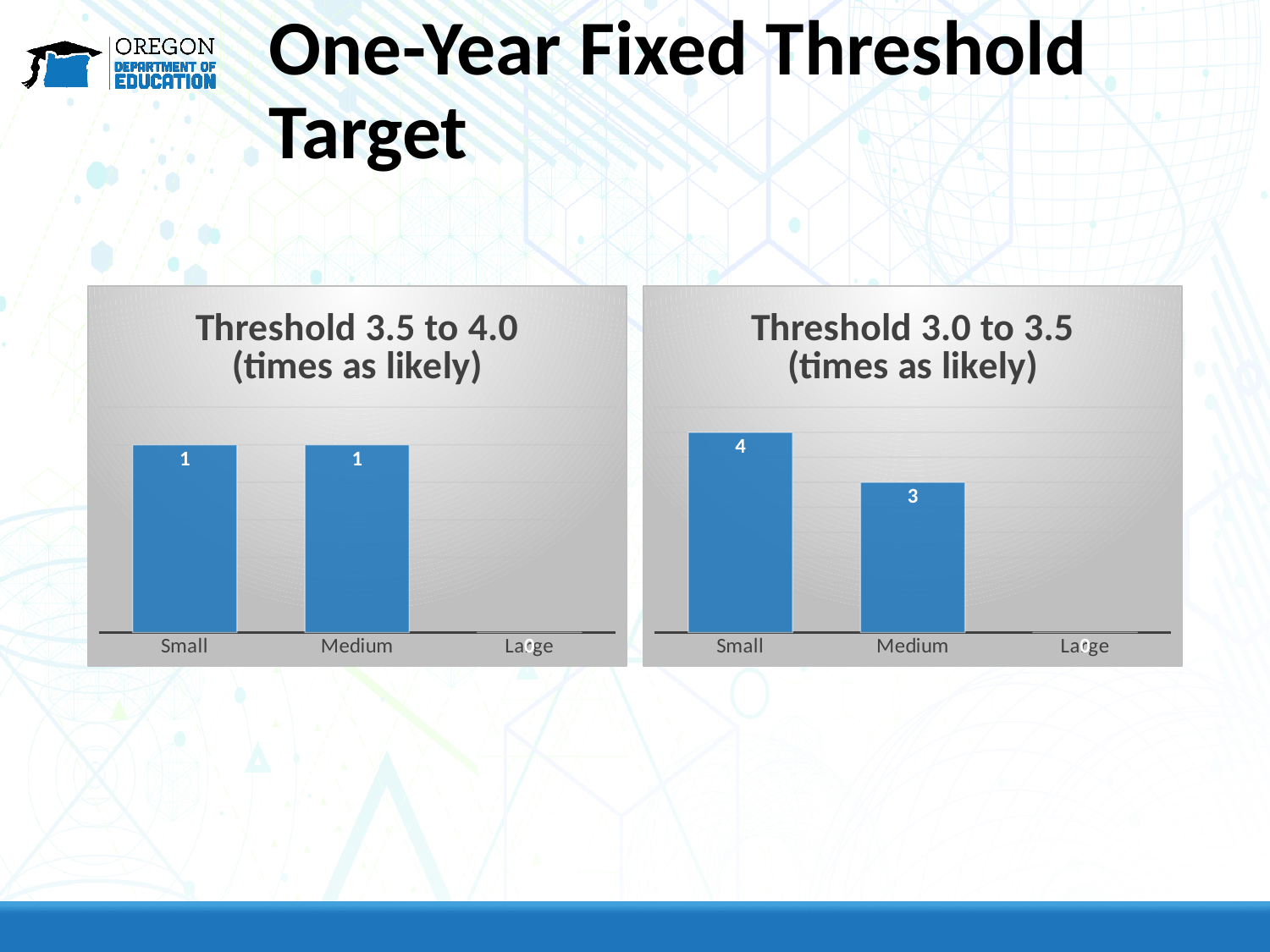
In the 'Threshold 3.0 to 3.5 (times as likely)' chart, what is the value for Small? 4 In the 'Threshold 3.0 to 3.5 (times as likely)' chart, which category has the lowest value? Large In the 'Threshold 3.5 to 4.0 (times as likely)' chart, what is the difference between the values for Medium and Large? 1 In the 'Threshold 3.0 to 3.5 (times as likely)' chart, do the values rise or fall from Small to Large? fall In the 'Threshold 3.0 to 3.5 (times as likely)' chart, which is larger, the value for Small or the value for Medium? Small In the 'Threshold 3.5 to 4.0 (times as likely)' chart, what is the value for Small? 1 How many categories are shown in the 'Threshold 3.5 to 4.0 (times as likely)' chart? 3 In the 'Threshold 3.5 to 4.0 (times as likely)' chart, what is the value for Large? 0 In the 'Threshold 3.0 to 3.5 (times as likely)' chart, what is the value for Medium? 3 In the 'Threshold 3.0 to 3.5 (times as likely)' chart, which category has the highest value? Small In the 'Threshold 3.0 to 3.5 (times as likely)' chart, what is the difference between the values for Small and Medium? 1 What kind of chart is the 'Threshold 3.0 to 3.5 (times as likely)' chart? bar chart